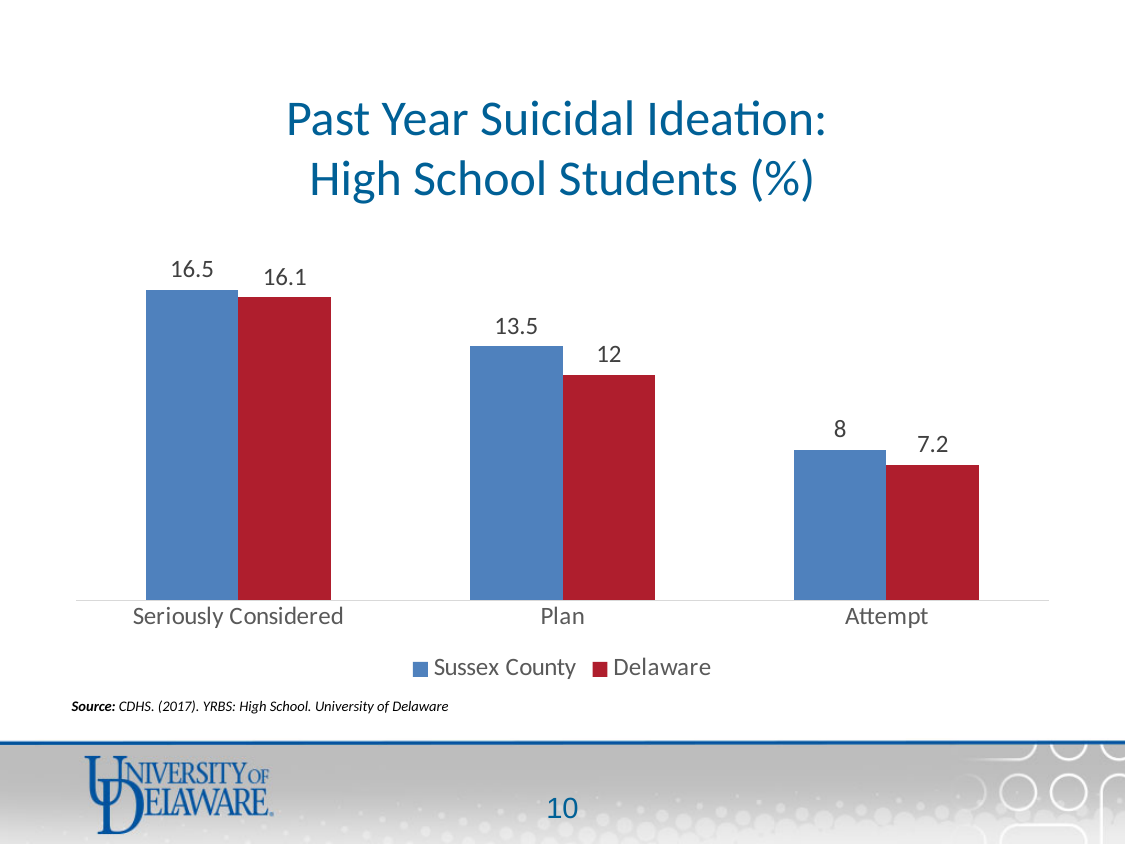
What kind of chart is shown on the slide? Bar chart How many categories are shown on the x axis? 3 Which category has the highest value for Sussex County? Seriously Considered What colour represents Delaware in the chart? Red What is the value for Delaware in the Plan category? 12 What is the value for Sussex County in the Seriously Considered category? 16.5 Which is larger in the Attempt category, Sussex County or Delaware? Sussex County What is the value for Delaware in the Attempt category? 7.2 What is the difference between Sussex County and Delaware in the Plan category? 1.5 Which category has the lowest value for Delaware? Attempt How many series does the legend list? 2 Do the Sussex County values rise or fall from Seriously Considered to Attempt? Fall